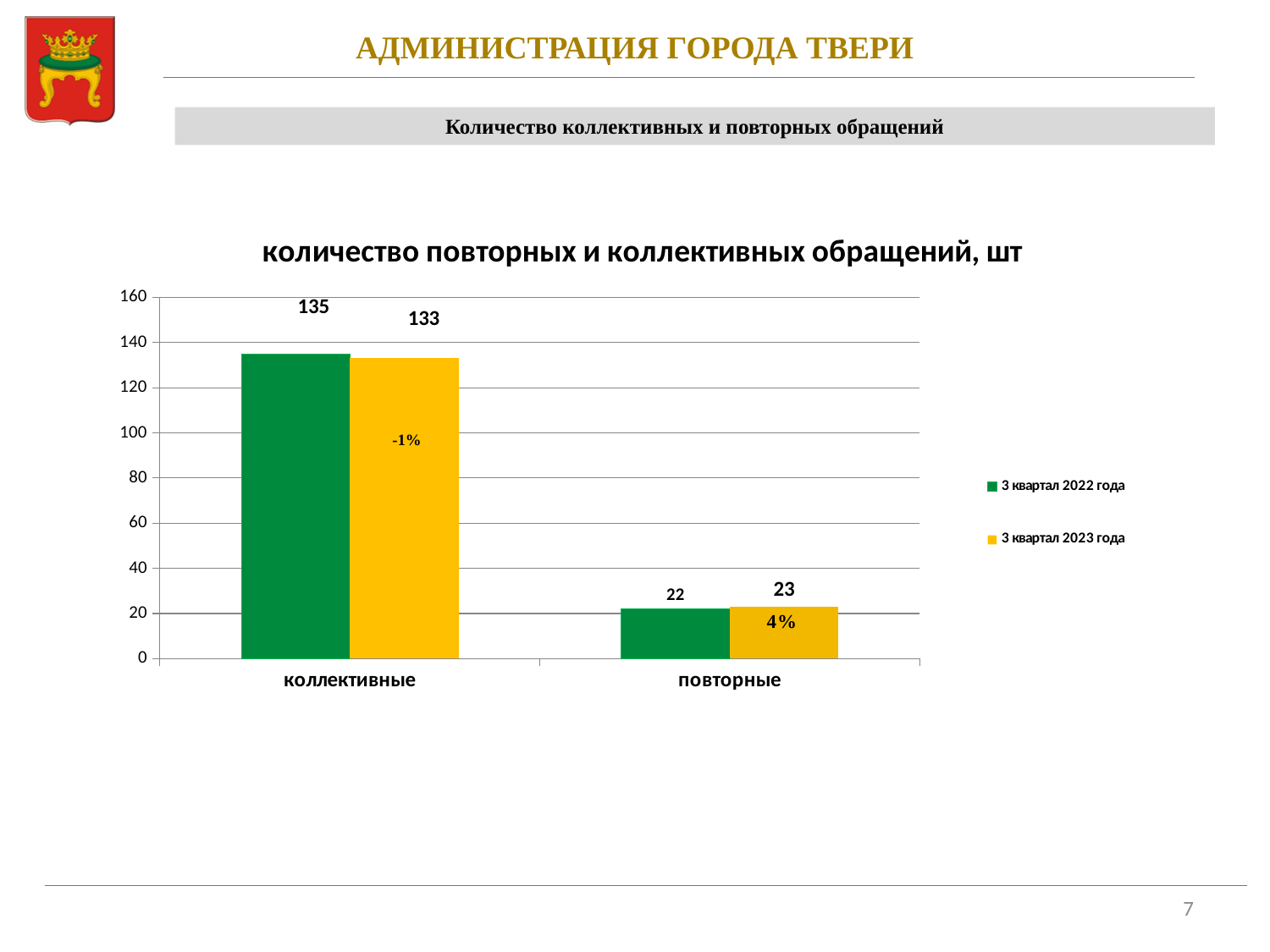
What is the value for коллективные in 3 квартал 2022 года? 135 How many categories are shown on the x axis? 2 What kind of chart is shown on the slide? bar chart How many series does the legend list? 2 What is the value for повторные in 3 квартал 2022 года? 22 What is the value for коллективные in 3 квартал 2023 года? 133 Which category has the highest value in 3 квартал 2023 года? коллективные Which category has the lowest value in 3 квартал 2022 года? повторные Which is larger: коллективные in 3 квартал 2022 года or повторные in 3 квартал 2023 года? коллективные in 3 квартал 2022 года What is the difference between коллективные in 3 квартал 2022 года and 3 квартал 2023 года? 2 What is the value for повторные in 3 квартал 2023 года? 23 What is the title of the chart? количество повторных и коллективных обращений, шт